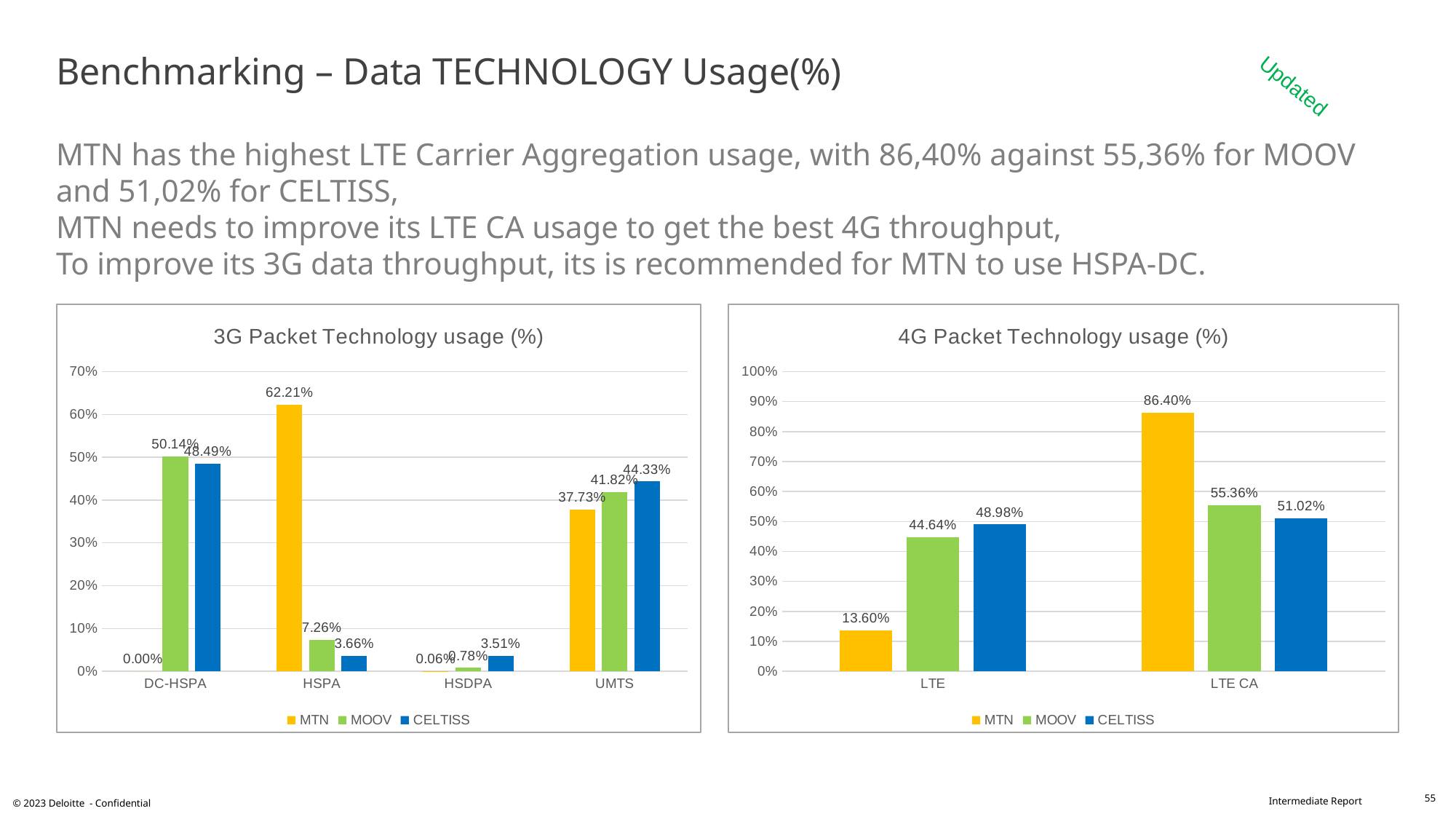
In the '3G Packet Technology usage (%)' chart, which colour represents MTN? yellow What kind of chart is the '4G Packet Technology usage (%)' chart? bar chart In the '3G Packet Technology usage (%)' chart, what is the value for MTN at HSPA? 62.21% How many series does the legend of the '4G Packet Technology usage (%)' chart list? 3 In the '4G Packet Technology usage (%)' chart, what is the value for MTN at LTE CA? 86.40% In the '3G Packet Technology usage (%)' chart, what is the value for MOOV at DC-HSPA? 50.14% In the '4G Packet Technology usage (%)' chart, what is the value for CELTISS at LTE? 48.98% In the '3G Packet Technology usage (%)' chart, is the value for MOOV at HSPA larger or smaller than the value for CELTISS at HSPA? larger In the '3G Packet Technology usage (%)' chart, which operator has the highest value at UMTS? CELTISS In the '4G Packet Technology usage (%)' chart, what is the difference between MTN and MOOV at LTE CA? 31.04% In the '4G Packet Technology usage (%)' chart, which operator has the lowest value at LTE? MTN How many categories are shown on the x axis of the '3G Packet Technology usage (%)' chart? 4